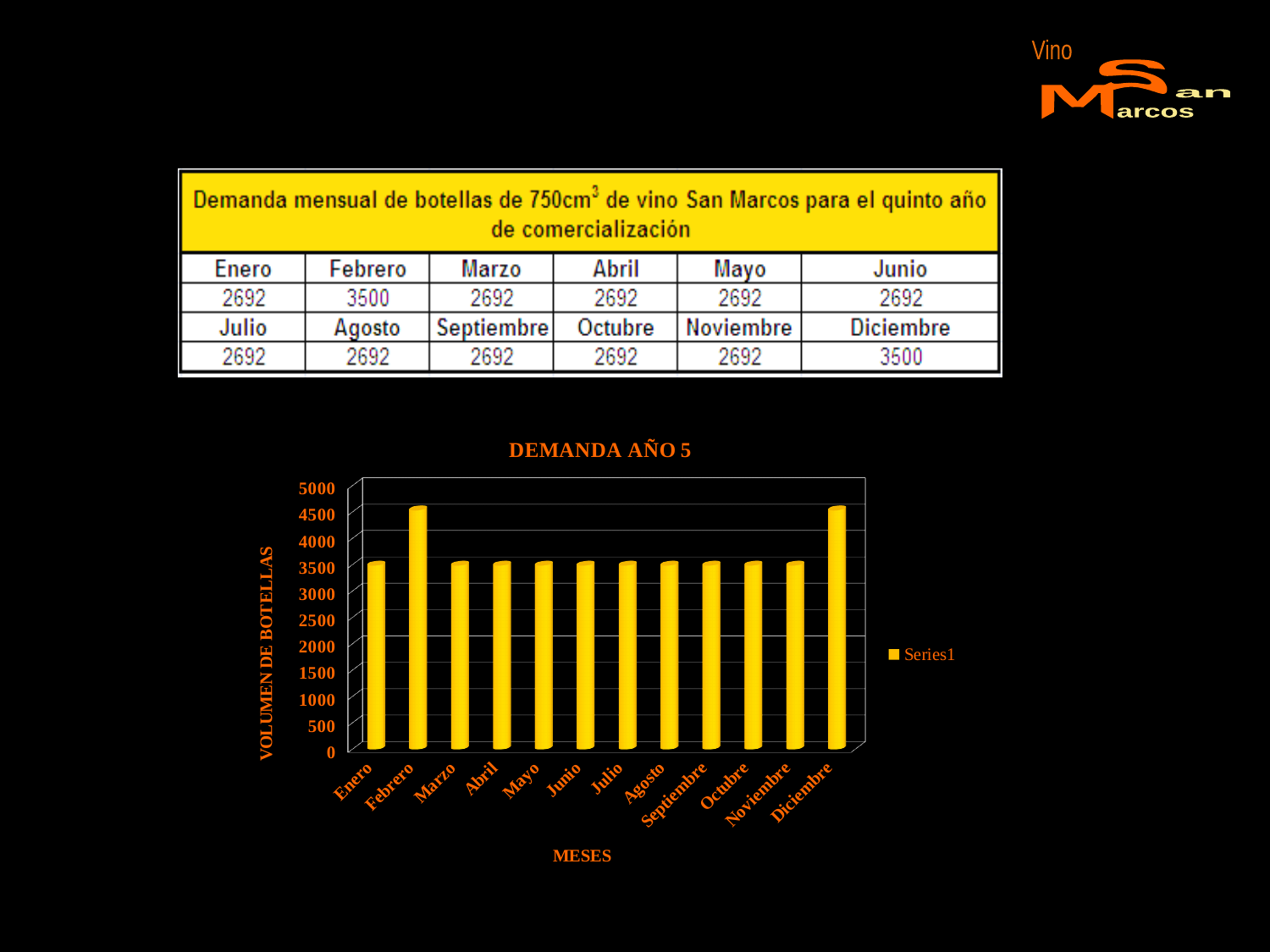
Which is larger, the value for Febrero or the value for Marzo? Febrero How many series does the chart legend list? 1 Is the value for Febrero greater or less than 4000? greater Which is larger, the value for Noviembre or the value for Diciembre? Diciembre What is the name of the series shown in the chart legend? Series1 What kind of chart is shown on the slide? bar chart What is the title of the chart? DEMANDA AÑO 5 How many months are plotted on the x axis of the chart? 12 Is the value for Enero greater or less than 4000? less Is the value for Julio greater or less than 4000? less